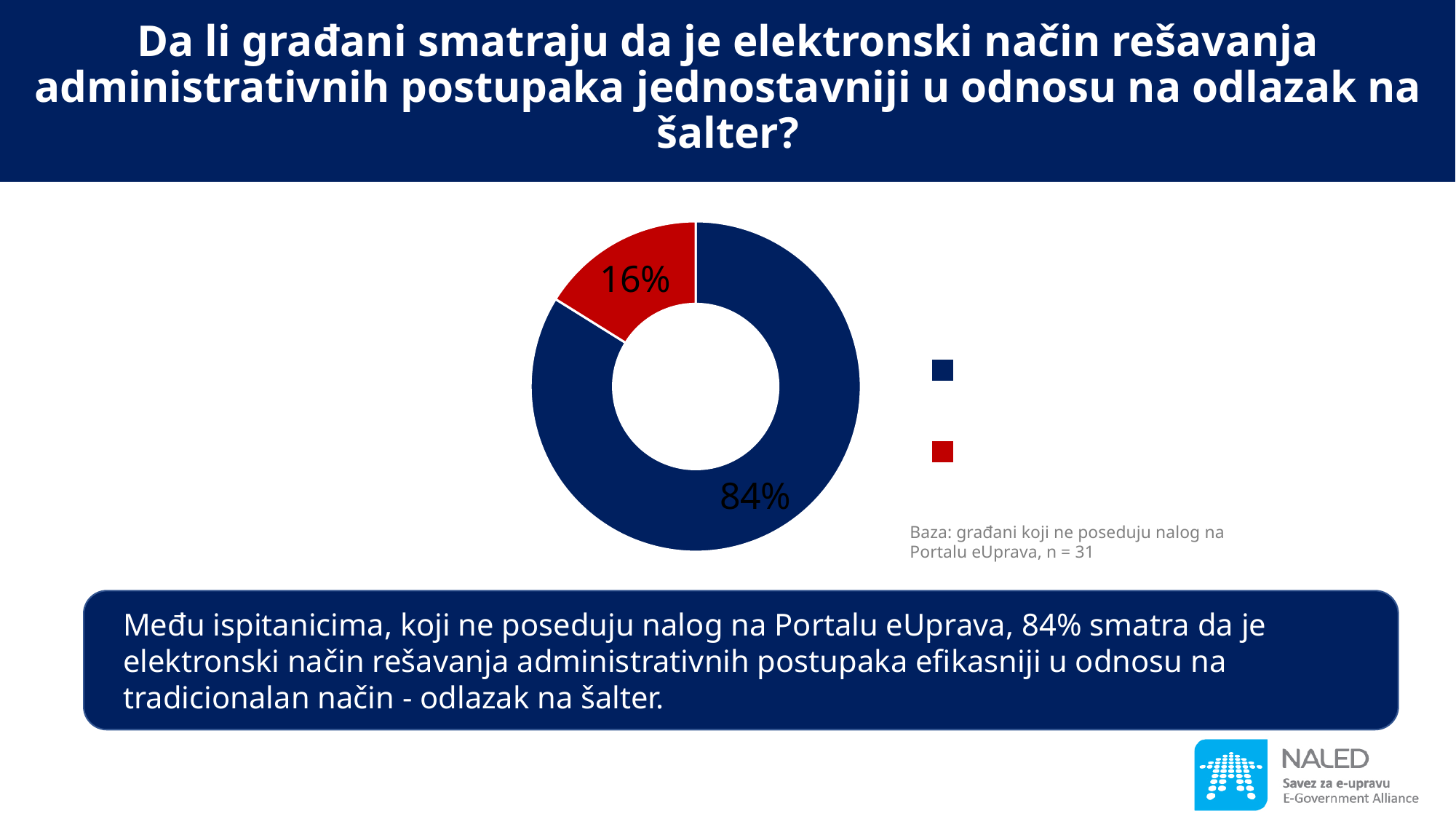
What share of the whole does the red slice represent? 16% Which slice of the chart is the largest? The dark blue slice (84%) Which slice of the chart is the smallest? The red slice (16%) What is the difference in percentage points between the dark blue slice and the red slice? 68 percentage points How many slices does the donut chart have? 2 Which slice is larger, the dark blue one or the red one? The dark blue one What percentage is shown for the dark blue slice of the chart? 84% What is the sample size (n) stated in the base note next to the chart? n = 31 How many entries does the legend of the chart list? 2 What kind of chart is shown on the slide? Pie chart (donut) What percentage is shown for the red slice of the chart? 16% Is the value of the dark blue slice greater or less than 50%? greater